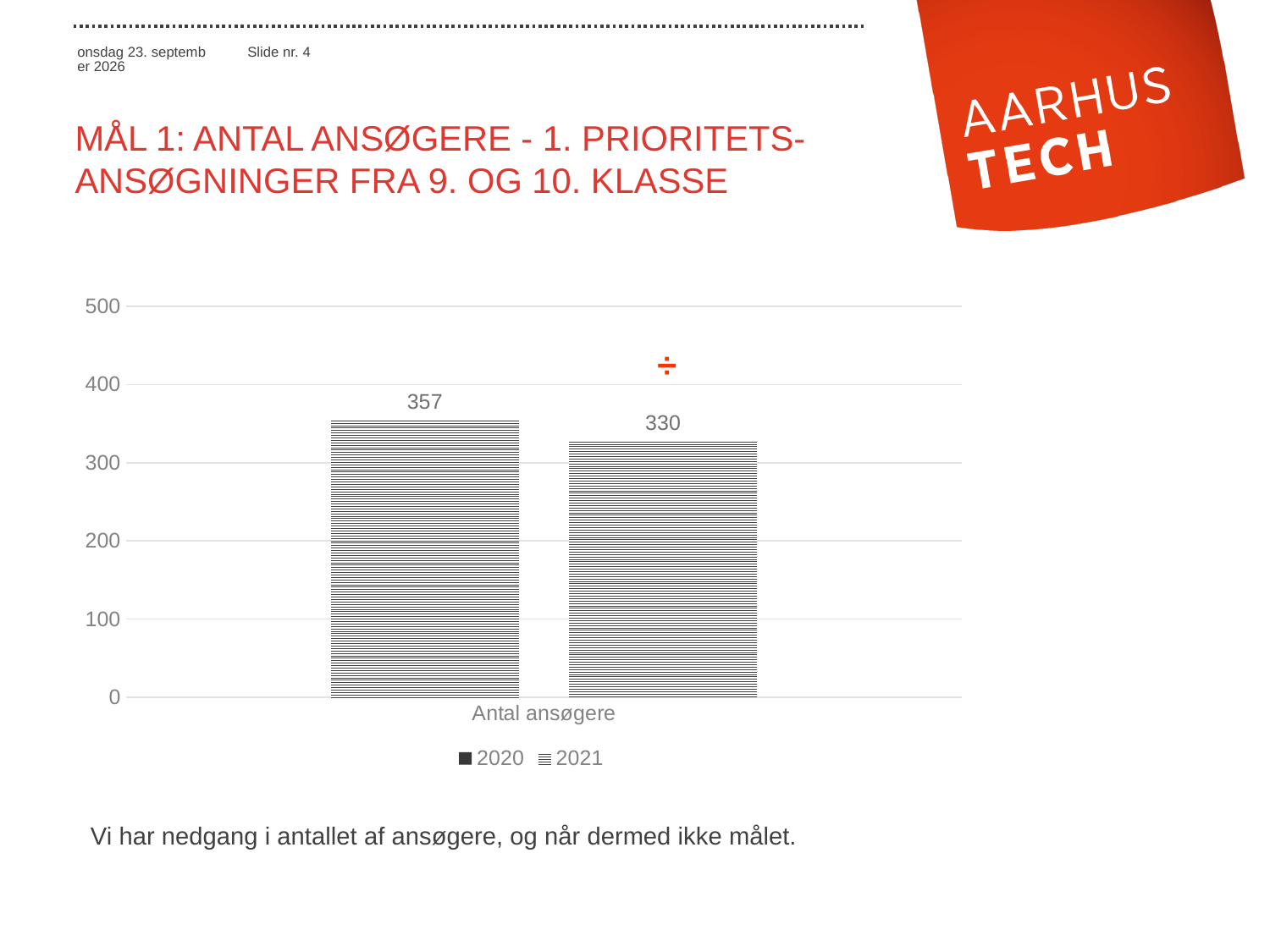
What is the value for 2020 in the Antal ansøgere chart? 357 Which series has the higher value, 2020 or 2021? 2020 What is the value for 2021 in the Antal ansøgere chart? 330 Do the values rise or fall from 2020 to 2021? fall What kind of chart is shown on the slide? bar chart Is the value for 2020 greater or less than 300? greater What is the difference between the 2020 and 2021 values? 27 How many series does the legend list? 2 Is the value for 2021 greater or less than 400? less What is the category label on the x axis of the chart? Antal ansøgere Which series has the lowest value in the chart? 2021 What is the highest value shown on the y axis of the chart? 500